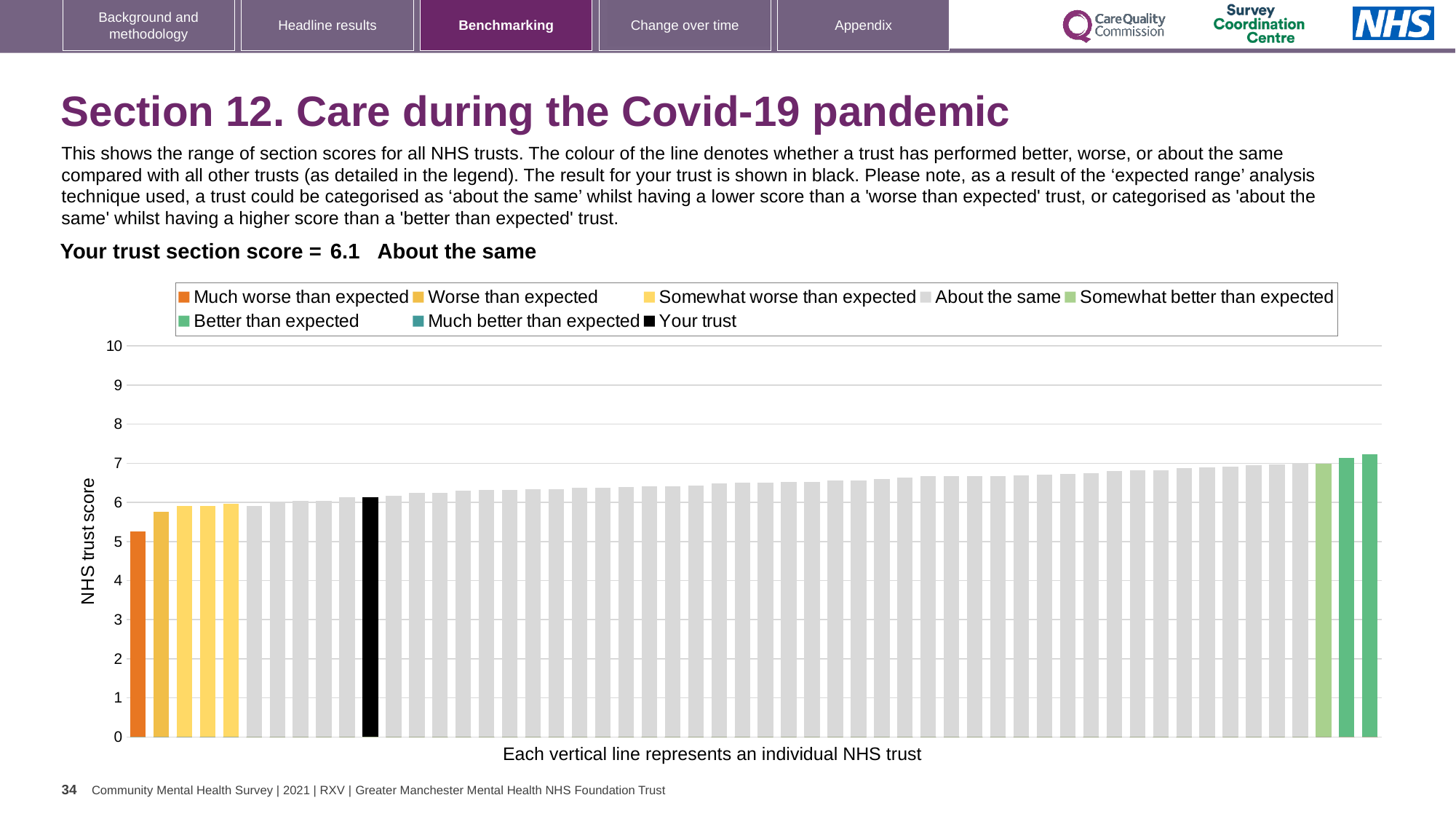
Which legend category does the shortest bar belong to? Much worse than expected What colour is used for the bar representing your trust? black How many entries does the chart legend list? 8 Is the score for your trust greater or less than 5? greater What is the section score for your trust shown on the slide? 6.1 Is the score of the lowest-scoring trust (the leftmost bar) greater or less than 6? less What is the label on the vertical axis of the chart? NHS trust score What kind of chart is shown on the slide? bar chart Is the score of the lowest-scoring trust (the leftmost bar) greater or less than 5? greater Which category is your trust placed in for this section? About the same Do the trust scores rise or fall moving from left to right along the x axis? rise